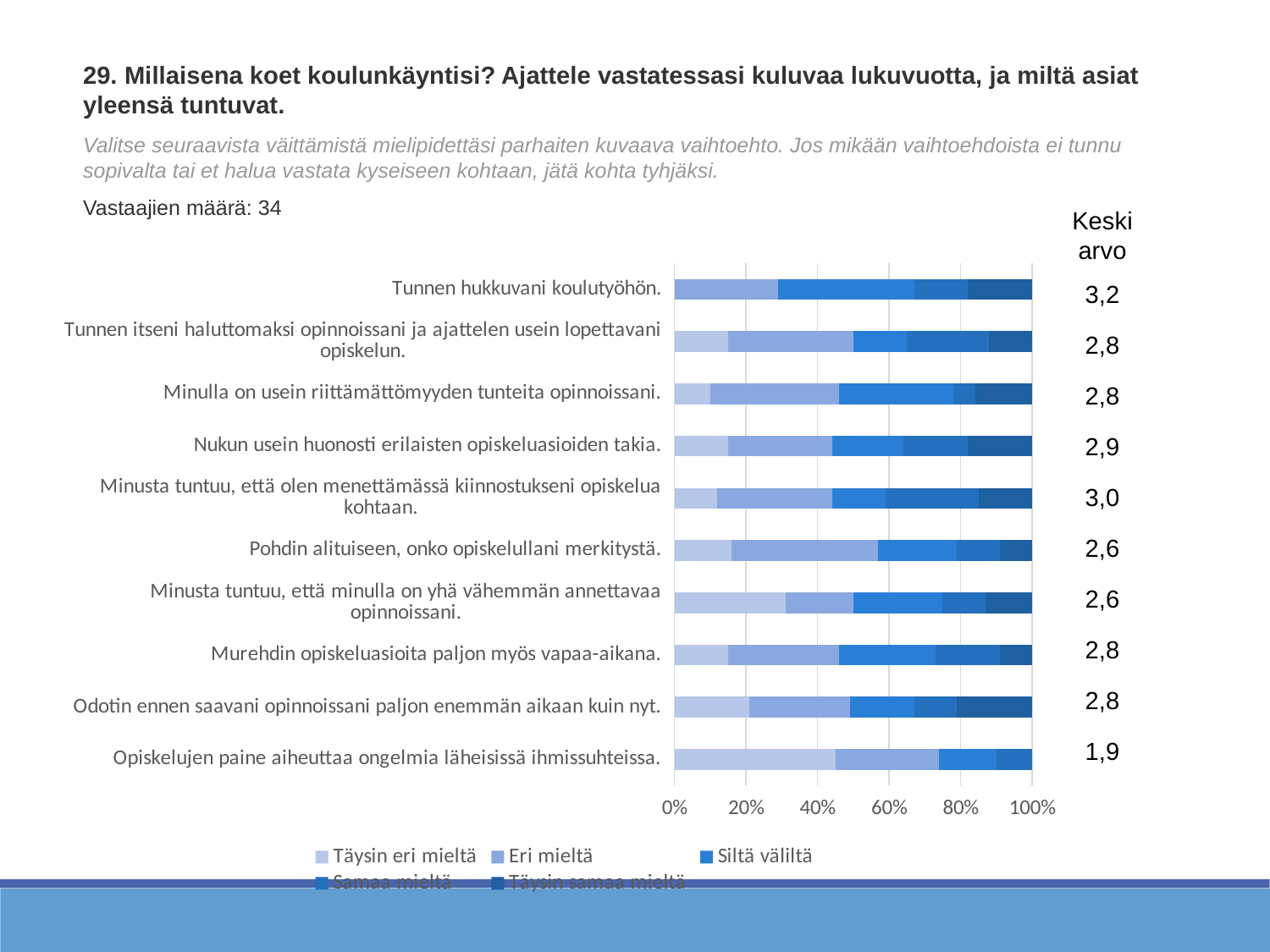
What is the Keskiarvo value for "Pohdin alituiseen, onko opiskelullani merkitystä."? 2,6 Which statement has the highest Keskiarvo value? Tunnen hukkuvani koulutyöhön. How many series does the legend list? 5 What kind of chart is shown on the slide? Stacked bar chart What is the Keskiarvo value for "Nukun usein huonosti erilaisten opiskeluasioiden takia."? 2,9 What is the difference between the highest and lowest Keskiarvo values? 1,3 Which has a larger Keskiarvo value: "Nukun usein huonosti erilaisten opiskeluasioiden takia." or "Pohdin alituiseen, onko opiskelullani merkitystä."? Nukun usein huonosti erilaisten opiskeluasioiden takia. Is the "Täysin eri mieltä" share for "Opiskelujen paine aiheuttaa ongelmia läheisissä ihmissuhteissa." greater or less than 40%? greater Which statement has the lowest Keskiarvo value? Opiskelujen paine aiheuttaa ongelmia läheisissä ihmissuhteissa. What is the Keskiarvo (mean) value for "Tunnen hukkuvani koulutyöhön."? 3,2 How many statements (categories) are shown in the chart? 10 What is the Keskiarvo value for "Opiskelujen paine aiheuttaa ongelmia läheisissä ihmissuhteissa."? 1,9